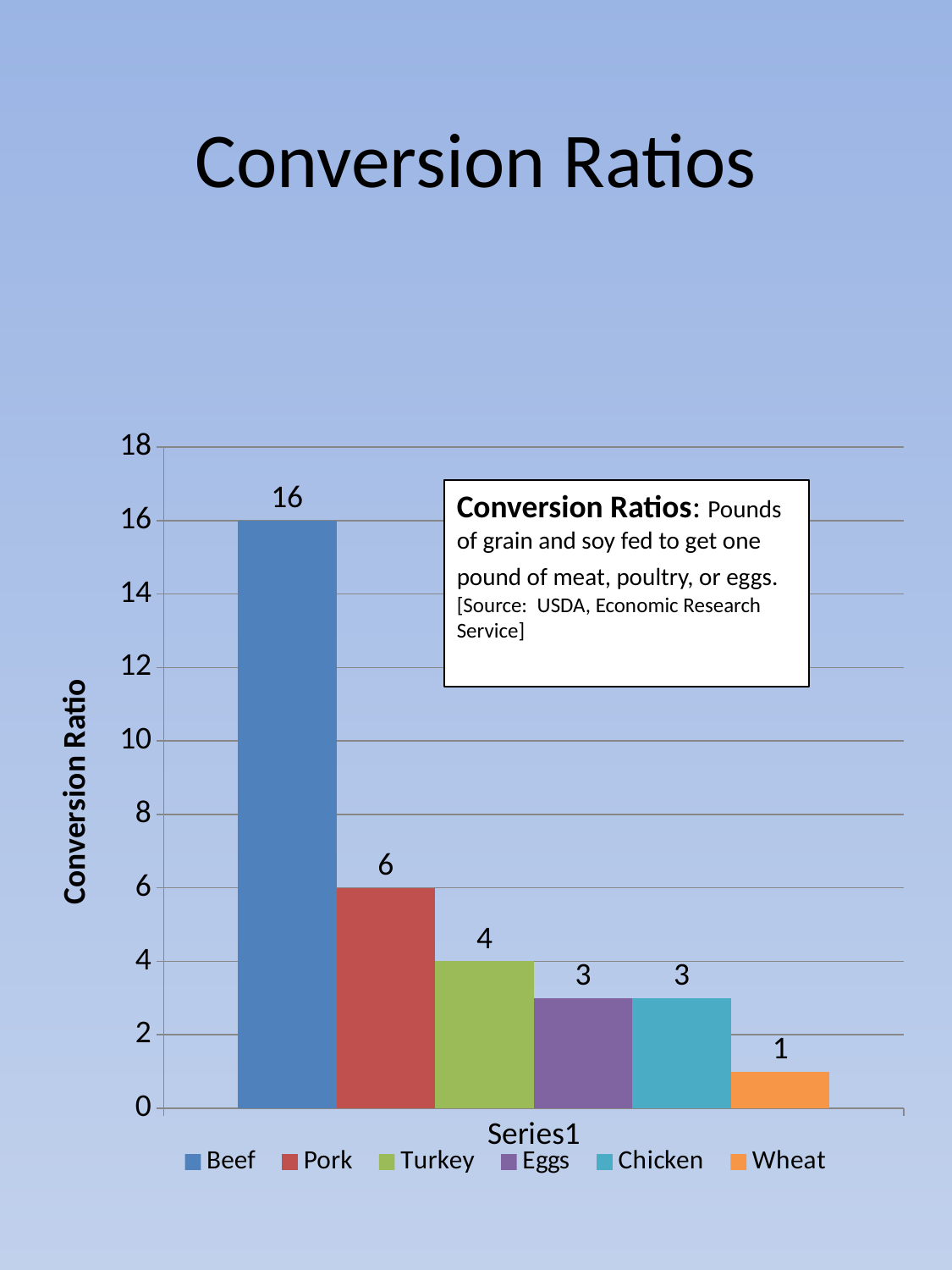
Which has a larger conversion ratio, Pork or Turkey? Pork What is the difference between the conversion ratios for Beef and Pork? 10 How many series does the legend list? 6 Is the value for Beef greater or less than 14? greater What is the label on the vertical axis of the chart? Conversion Ratio What is the conversion ratio for Pork? 6 What is the conversion ratio for Beef? 16 Which item has the highest conversion ratio? Beef What is the conversion ratio for Wheat? 1 Which item has the lowest conversion ratio? Wheat What is the difference between the conversion ratios for Turkey and Wheat? 3 What kind of chart is shown on the slide? Bar chart